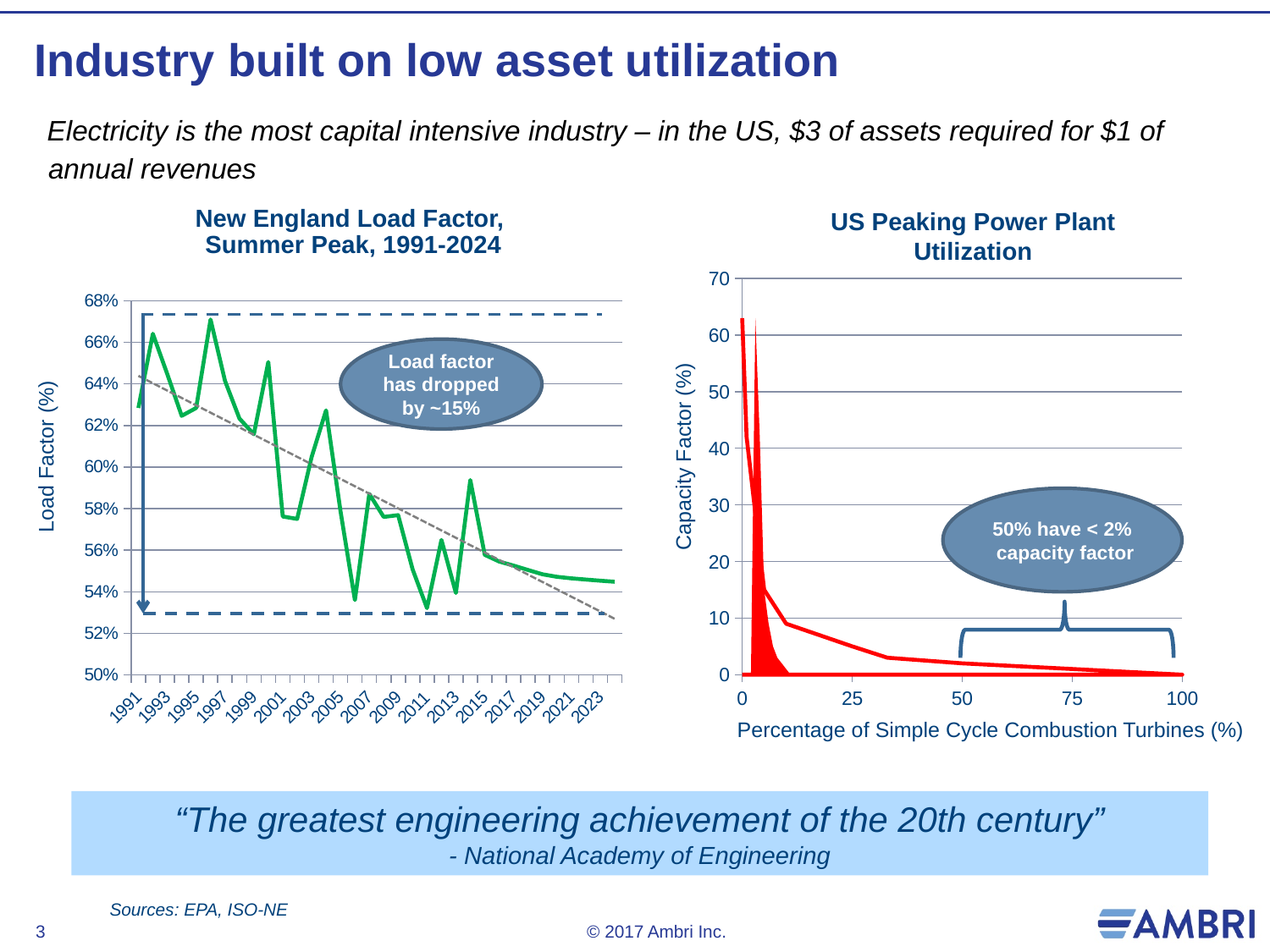
In the 'New England Load Factor, Summer Peak, 1991-2024' chart, is the value for 2023 greater or less than 56%? less In the 'US Peaking Power Plant Utilization' chart, does the capacity factor rise or fall as the percentage of simple cycle combustion turbines increases? fall In the 'US Peaking Power Plant Utilization' chart, is the capacity factor at 0% of turbines greater or less than 50? greater What is the y-axis label of the 'US Peaking Power Plant Utilization' chart? Capacity Factor (%) In the 'US Peaking Power Plant Utilization' chart, is the capacity factor at 75% of turbines greater or less than 10? less What does the callout on the 'New England Load Factor, Summer Peak, 1991-2024' chart say? Load factor has dropped by ~15% What kind of chart is the 'New England Load Factor, Summer Peak, 1991-2024' chart? line chart In the 'New England Load Factor, Summer Peak, 1991-2024' chart, does the load factor generally rise or fall from 1991 to 2024? fall In the 'New England Load Factor, Summer Peak, 1991-2024' chart, which year has a higher load factor, 1991 or 2011? 1991